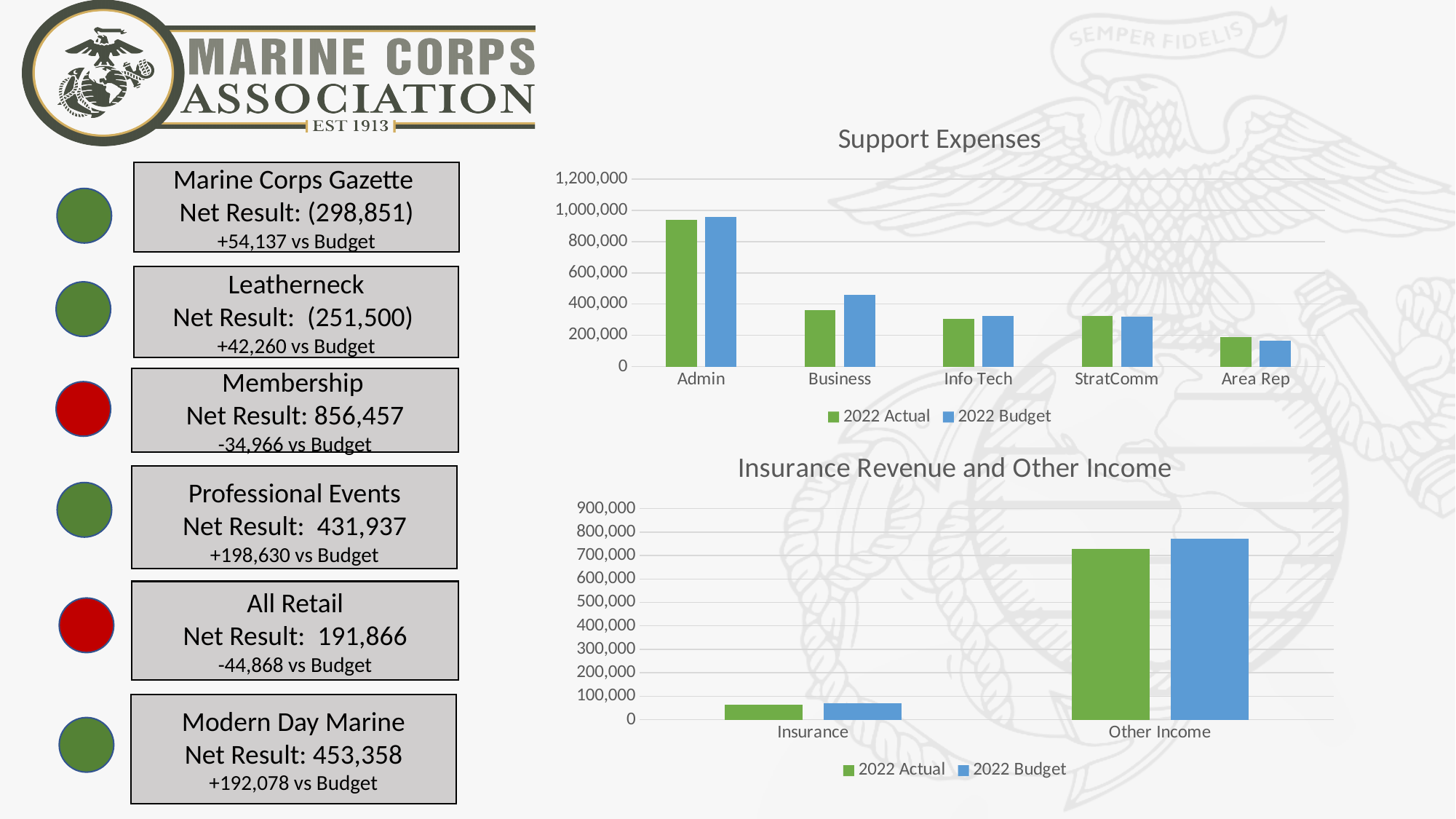
In the "Insurance Revenue and Other Income" chart, which category has the higher 2022 Actual value? Other Income In the "Support Expenses" chart, which is larger for Business: 2022 Actual or 2022 Budget? 2022 Budget In the "Insurance Revenue and Other Income" chart, is the 2022 Actual value for Insurance greater or less than 100,000? less How many categories are shown on the x axis of the "Support Expenses" chart? 5 What kind of chart is the "Support Expenses" chart? bar chart In the "Support Expenses" chart, which category has the highest 2022 Actual value? Admin How many categories are shown on the x axis of the "Insurance Revenue and Other Income" chart? 2 In the "Support Expenses" chart, is the 2022 Budget value for Business greater or less than 400,000? greater In the "Support Expenses" chart, is the 2022 Actual value for Admin greater or less than 800,000? greater How many series does the legend of the "Support Expenses" chart list? 2 In the "Support Expenses" chart, which category has the lowest 2022 Actual value? Area Rep